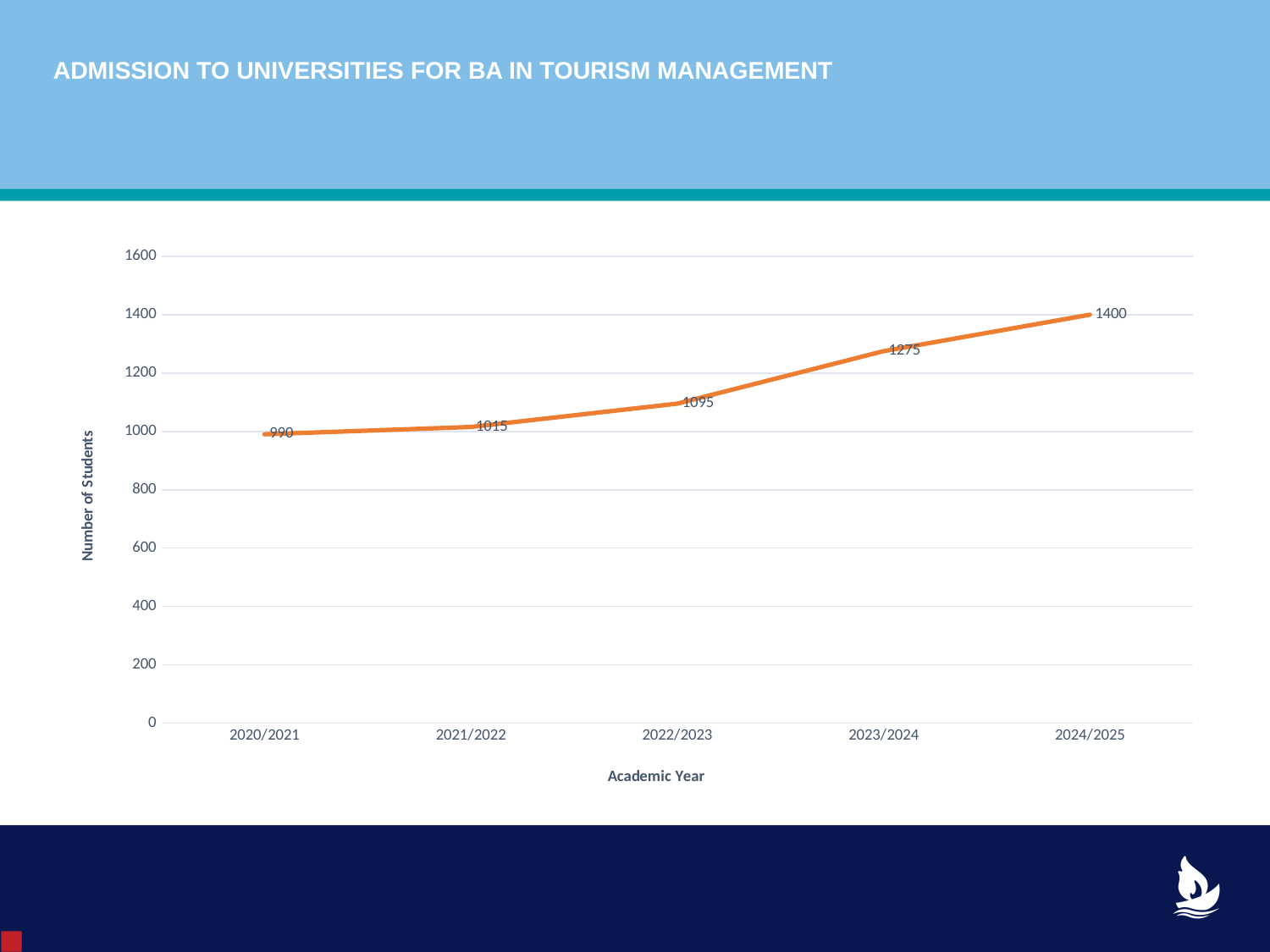
Which academic year has the lowest number of students? 2020/2021 What is the number of students admitted in 2024/2025? 1400 What is the number of students admitted in 2022/2023? 1095 Do the values rise or fall from 2020/2021 to 2024/2025? rise What is the number of students admitted in 2020/2021? 990 Which year has more students, 2021/2022 or 2023/2024? 2023/2024 How many academic years are plotted on the chart? 5 What is the difference in number of students between 2023/2024 and 2022/2023? 180 What is the difference in number of students between 2024/2025 and 2020/2021? 410 Is the value for 2023/2024 greater or less than 1200? greater Which academic year has the highest number of students? 2024/2025 What kind of chart is shown on the slide? line chart